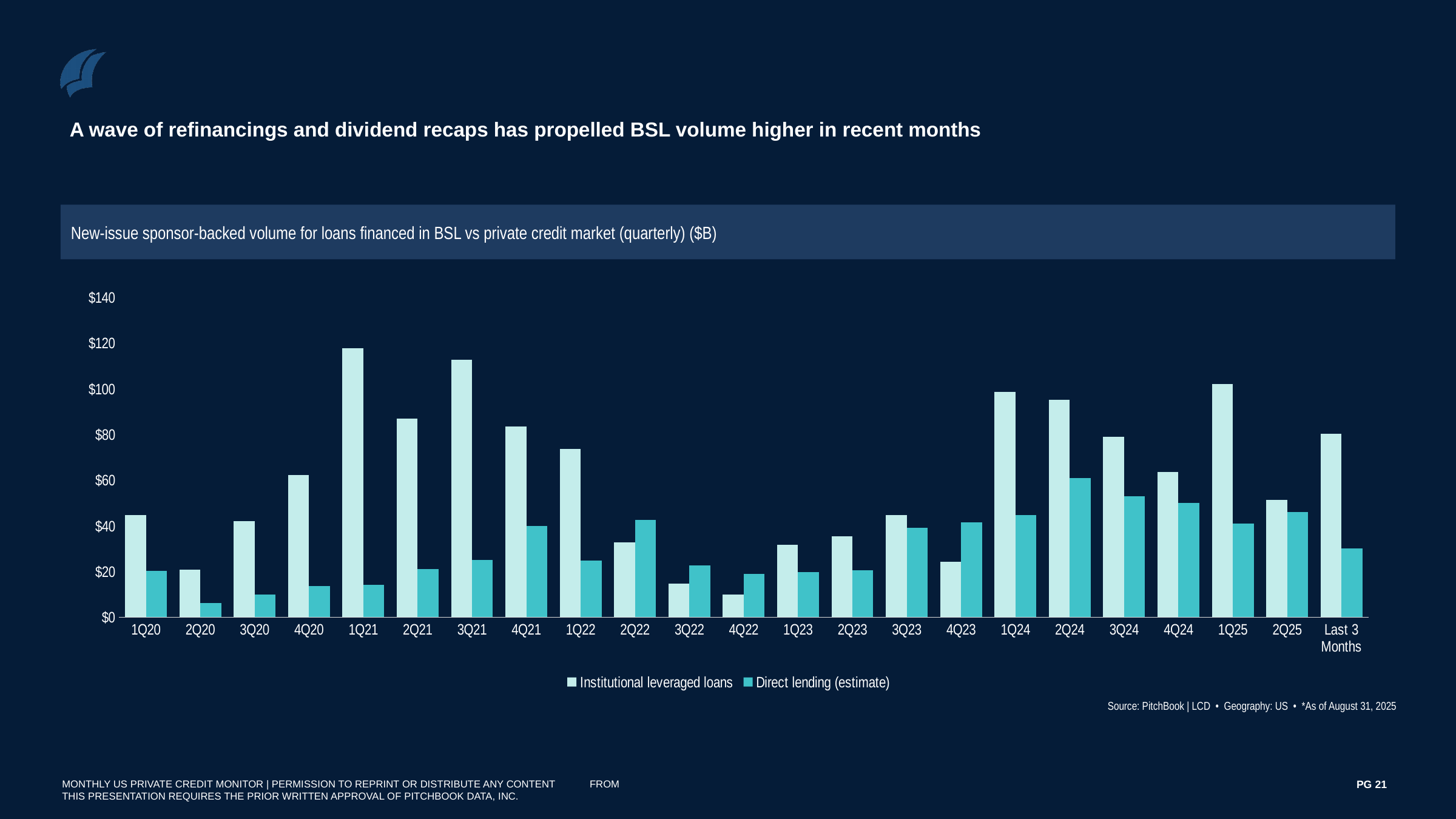
What kind of chart is shown on the slide? Bar chart In which quarter is the Institutional leveraged loans value highest? 1Q21 In which quarter is the Direct lending (estimate) value lowest? 2Q20 Do the Institutional leveraged loans values rise or fall from 1Q22 to 4Q22? Fall How many series does the legend list? 2 Is the Institutional leveraged loans value for 1Q21 greater or less than $100? greater In 4Q23, which is larger: Institutional leveraged loans or Direct lending (estimate)? Direct lending (estimate) In which quarter is the Direct lending (estimate) value highest? 2Q24 How many categories are shown on the x axis? 23 Is the Direct lending (estimate) value for 2Q24 greater or less than $40? greater Is the Institutional leveraged loans value for 4Q22 greater or less than $20? less In which quarter is the Institutional leveraged loans value lowest? 4Q22